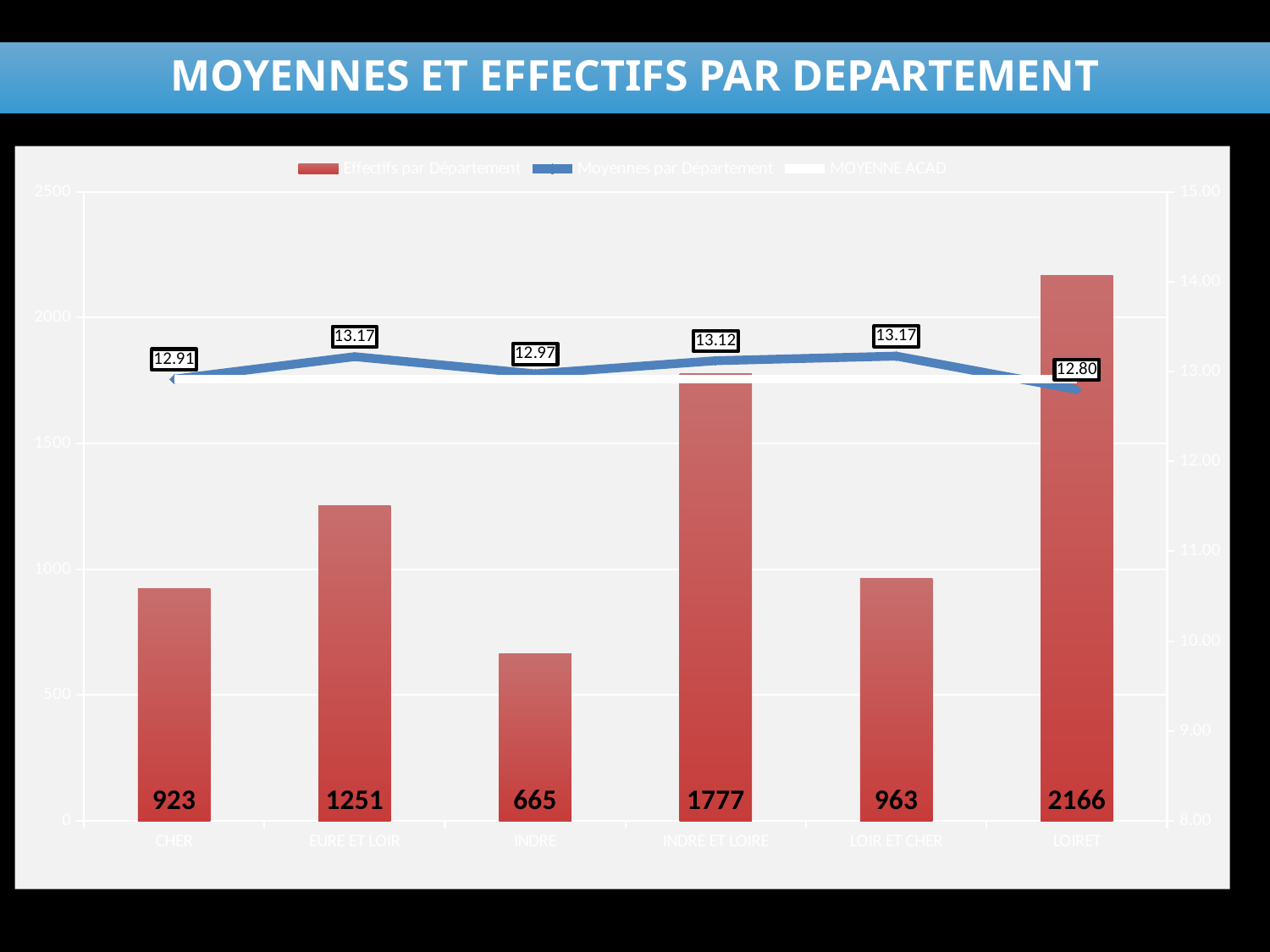
What is the title of the slide? MOYENNES ET EFFECTIFS PAR DEPARTEMENT Is the Effectifs par Département value for EURE ET LOIR greater or less than 1000? greater Which department has the lowest Moyennes par Département? LOIRET Which department has the highest Effectifs par Département? LOIRET How many departments are shown on the x axis? 6 What is the difference in Effectifs par Département between LOIRET and INDRE? 1501 What is the Moyennes par Département value for EURE ET LOIR? 13.17 Which department has the lowest Effectifs par Département? INDRE How many series does the legend list? 3 What is the Moyennes par Département value for LOIRET? 12.80 Which has a larger Effectifs par Département, CHER or LOIR ET CHER? LOIR ET CHER What is the value of Effectifs par Département for INDRE ET LOIRE? 1777